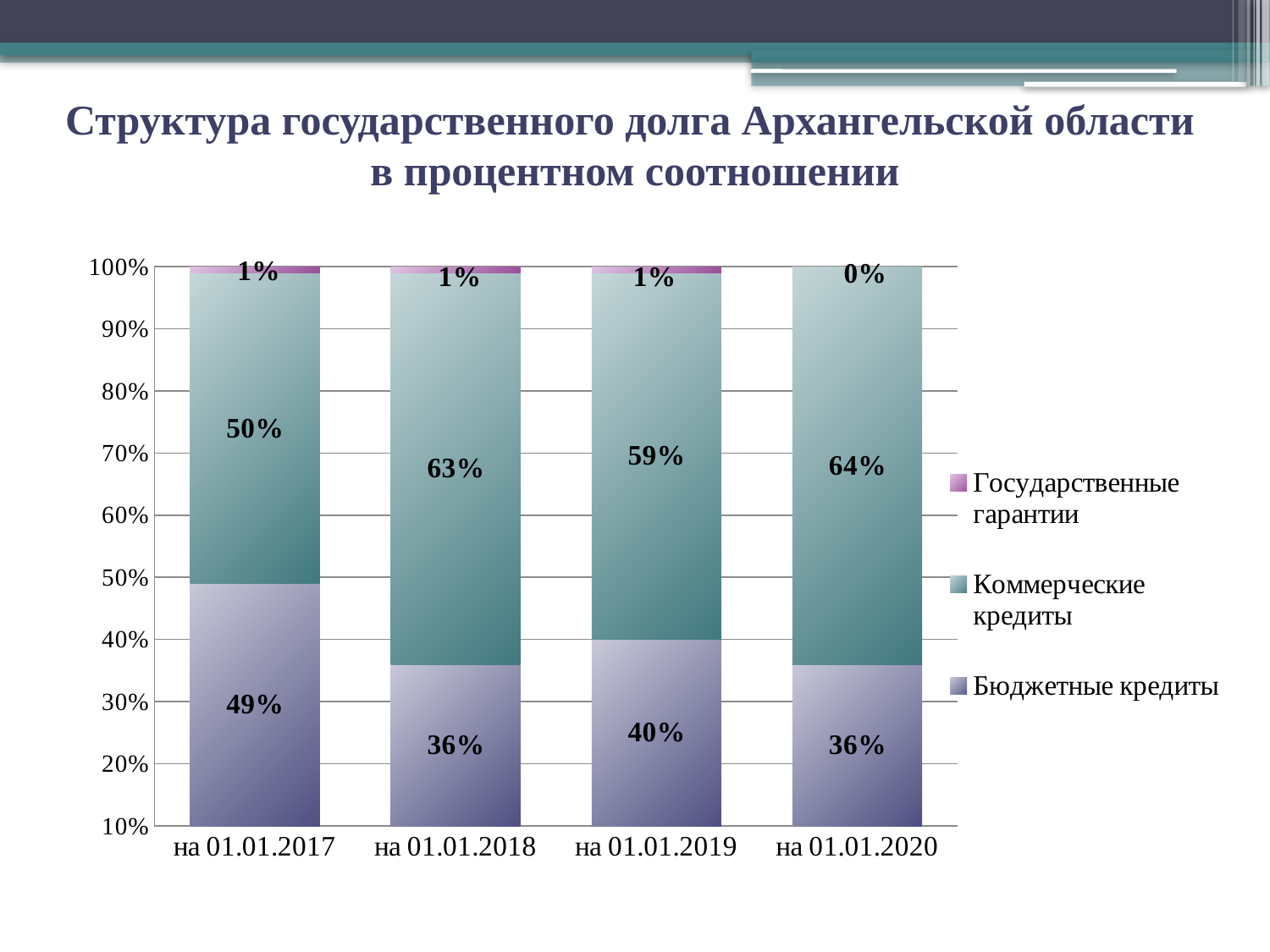
What is the share of Государственные гарантии on 01.01.2020? 0% What kind of chart is shown on the slide? Stacked bar chart What is the share of Бюджетные кредиты on 01.01.2017? 49% What is the share of Коммерческие кредиты on 01.01.2018? 63% On which date is the share of Бюджетные кредиты the highest? на 01.01.2017 How many series does the legend list? 3 What is the difference between the share of Коммерческие кредиты and Бюджетные кредиты on 01.01.2019? 19% What is the title of the chart? Структура государственного долга Архангельской области в процентном соотношении Which is larger on 01.01.2017: the share of Коммерческие кредиты or Бюджетные кредиты? Коммерческие кредиты Does the share of Коммерческие кредиты rise or fall from 01.01.2017 to 01.01.2018? Rise How many dates (categories) are shown on the x axis? 4 On which date is the share of Коммерческие кредиты the highest? на 01.01.2020